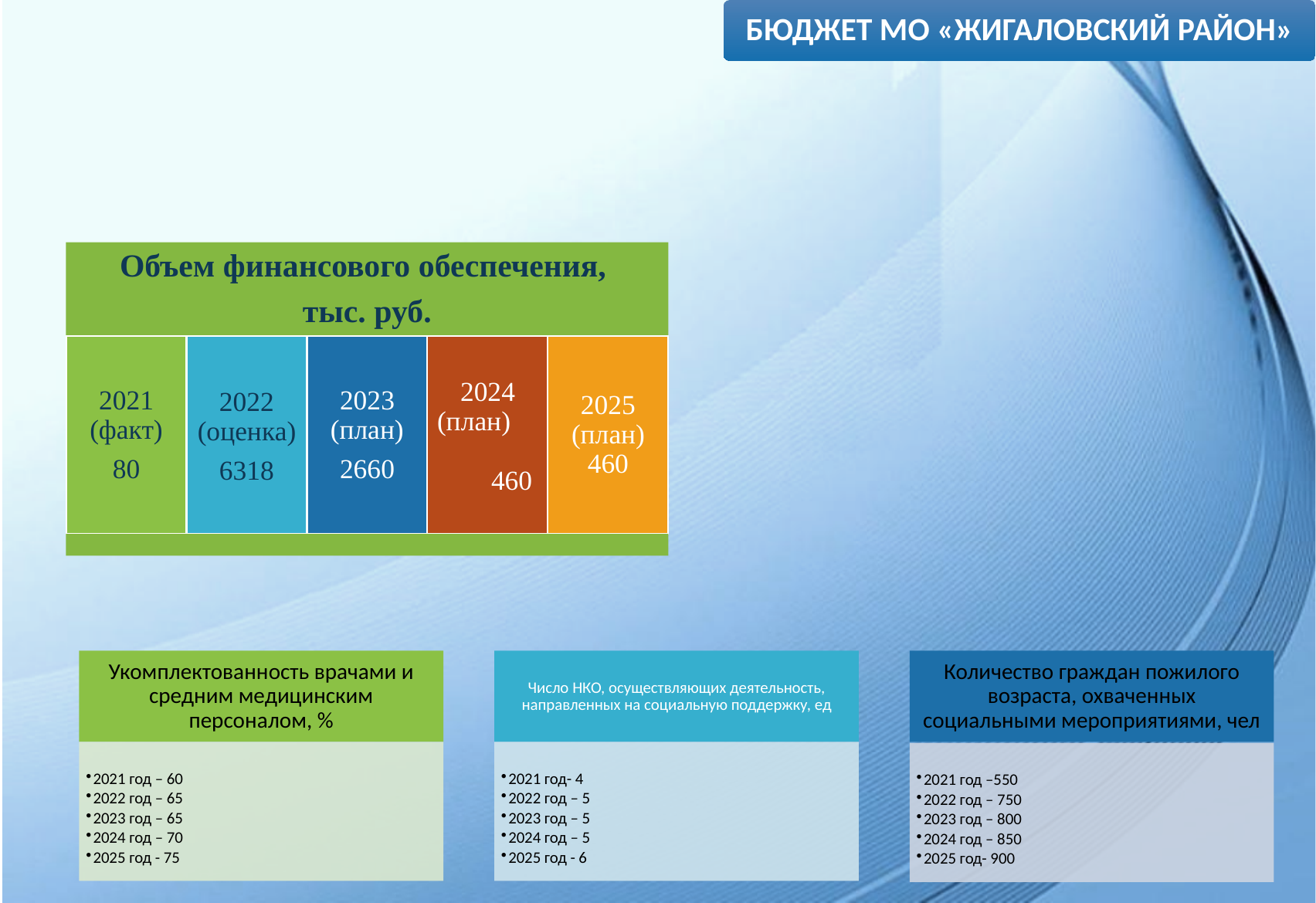
In the 'Объем финансового обеспечения, тыс. руб.' graphic, which is larger: the value for 2023 (план) or 2024 (план)? 2023 (план) In the 'Объем финансового обеспечения, тыс. руб.' graphic, which year has the highest value? 2022 (оценка) In the 'Объем финансового обеспечения, тыс. руб.' graphic, what is the value for 2023 (план)? 2660 In the 'Объем финансового обеспечения, тыс. руб.' graphic, what is the difference between the 2022 (оценка) and 2023 (план) values? 3658 In the 'Объем финансового обеспечения, тыс. руб.' graphic, what colour is the block for 2024 (план)? Dark orange (brown-red) In the 'Объем финансового обеспечения, тыс. руб.' graphic, which year has the lowest value? 2021 (факт) In the 'Объем финансового обеспечения, тыс. руб.' graphic, what is the value for 2022 (оценка)? 6318 In the 'Объем финансового обеспечения, тыс. руб.' graphic, what is the difference between the 2021 (факт) and 2024 (план) values? 380 What is the title of the colored block graphic on the slide? Объем финансового обеспечения, тыс. руб. In the 'Объем финансового обеспечения, тыс. руб.' graphic, what is the value for 2025 (план)? 460 In the 'Объем финансового обеспечения, тыс. руб.' graphic, what is the value for 2021 (факт)? 80 How many years are shown in the 'Объем финансового обеспечения, тыс. руб.' graphic? 5